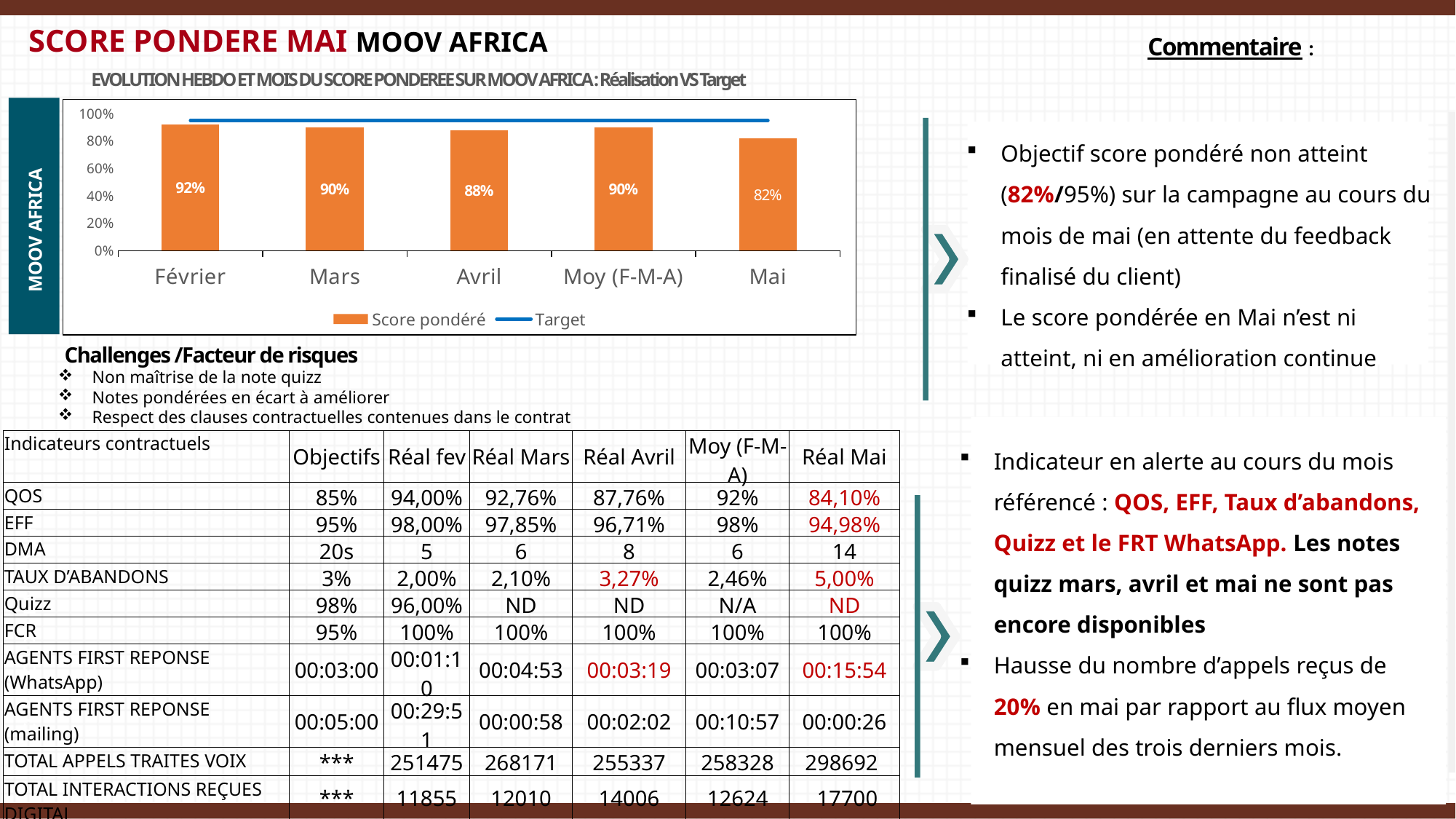
Which category has the lowest Score pondéré? Mai Which category has the highest Score pondéré? Février What type of chart is used to show the Score pondéré? bar chart What is the Score pondéré value for Février? 92% Is the Target line value greater or less than 80%? greater What is the difference between the Score pondéré for Février and Mai? 10% What is the Score pondéré value for Moy (F-M-A)? 90% What is the Score pondéré value for Mai? 82% Which is larger, the Score pondéré for Mars or for Avril? Mars What is the Score pondéré value for Avril? 88% How many series does the chart legend list? 2 How many categories are shown on the x axis of the chart? 5